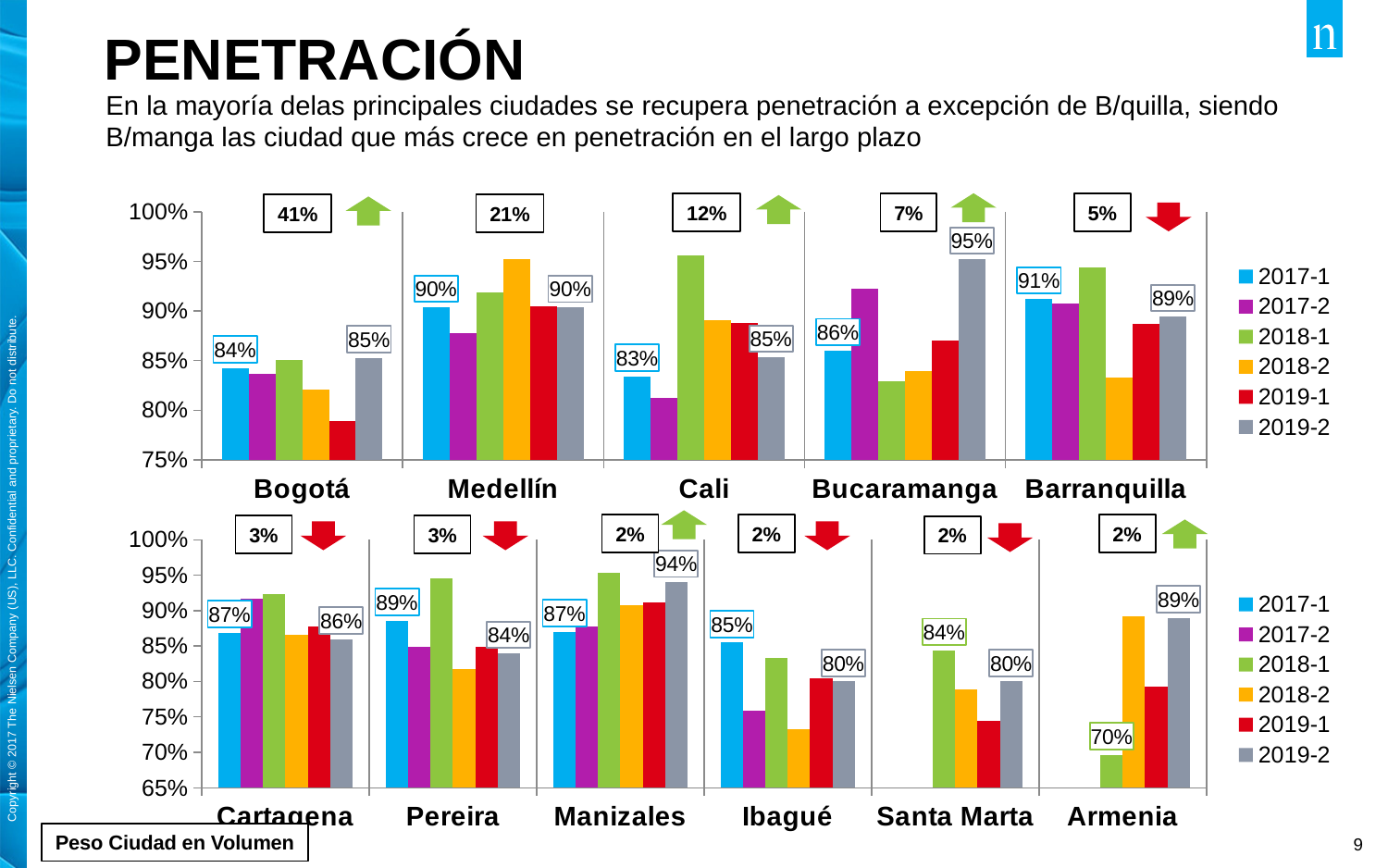
In the bottom chart, what is the 2019-2 value for Manizales? 94% In the top chart, what is the difference between the 2019-2 and 2017-1 values for Bucaramanga? 9% In the bottom chart, what is the 2018-1 value for Armenia? 70% In the top chart, what is the 2019-2 value for Bucaramanga? 95% In the bottom chart, what is the difference between the 2017-1 and 2019-2 values for Ibagué? 5% How many cities are shown in the bottom chart? 6 In the top chart, which is larger for Barranquilla: the 2017-1 value or the 2019-2 value? 2017-1 What type of chart is used on this slide? Bar chart In the top chart, what is the 2017-1 value for Cali? 83% How many series does the legend of the top chart list? 6 In the bottom chart, is the 2018-2 value for Ibagué greater or less than 75%? less